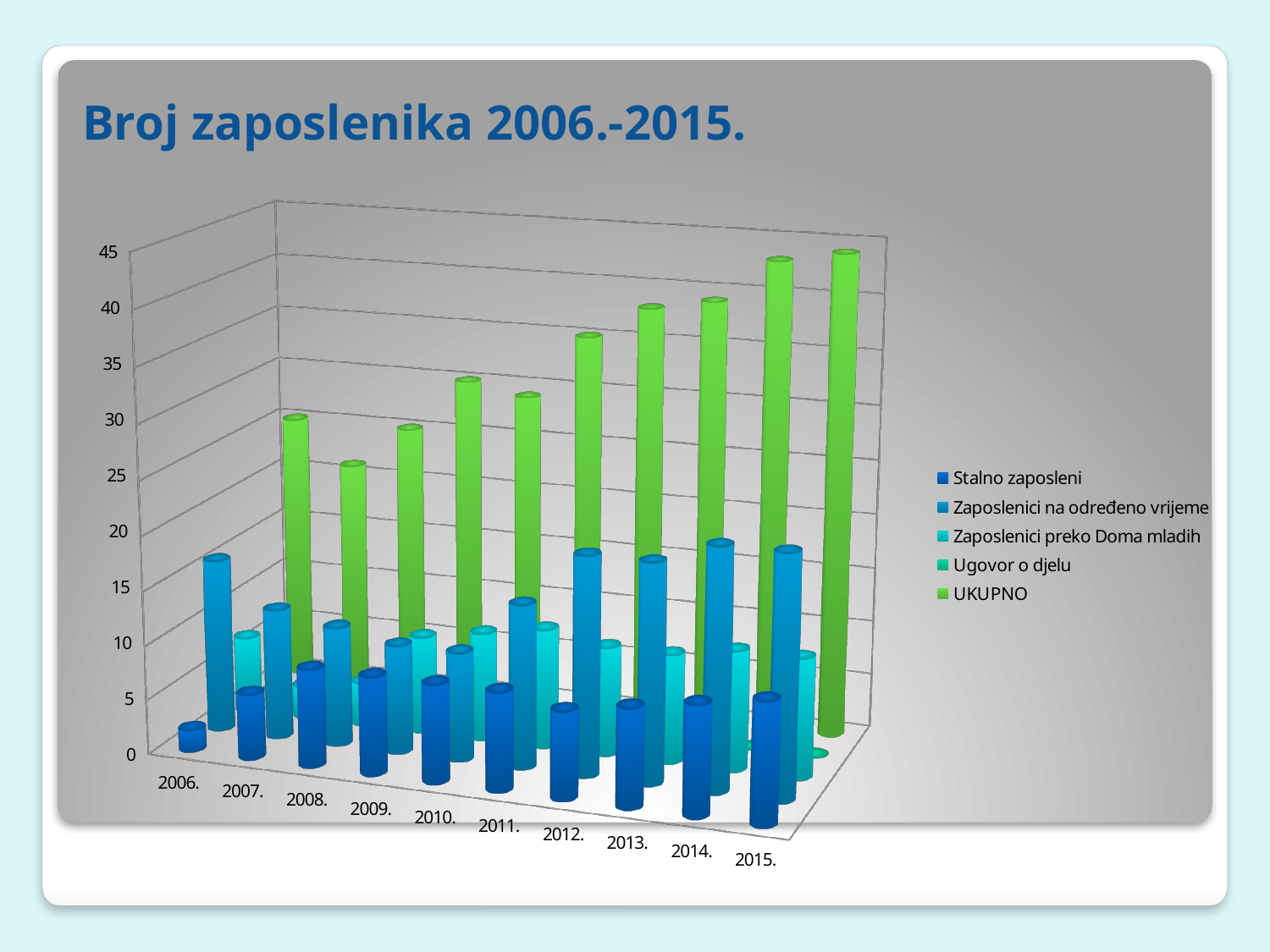
Is the UKUPNO value for 2015. greater or less than 40? greater Which series is shown in green in the legend? UKUPNO Is the Stalno zaposleni value for 2006. greater or less than 5? less Which is larger, the Stalno zaposleni value for 2006. or for 2015.? 2015. What is the title of the chart? Broj zaposlenika 2006.-2015. How many years (categories) are shown on the x axis? 10 Is the UKUPNO value for 2007. greater or less than 30? less Does the UKUPNO series generally rise or fall from 2006. to 2015.? rise How many series does the legend list? 5 What kind of chart is shown on the slide? bar chart In which year is the UKUPNO value lowest? 2007. Which series has the tallest bars in every year? UKUPNO